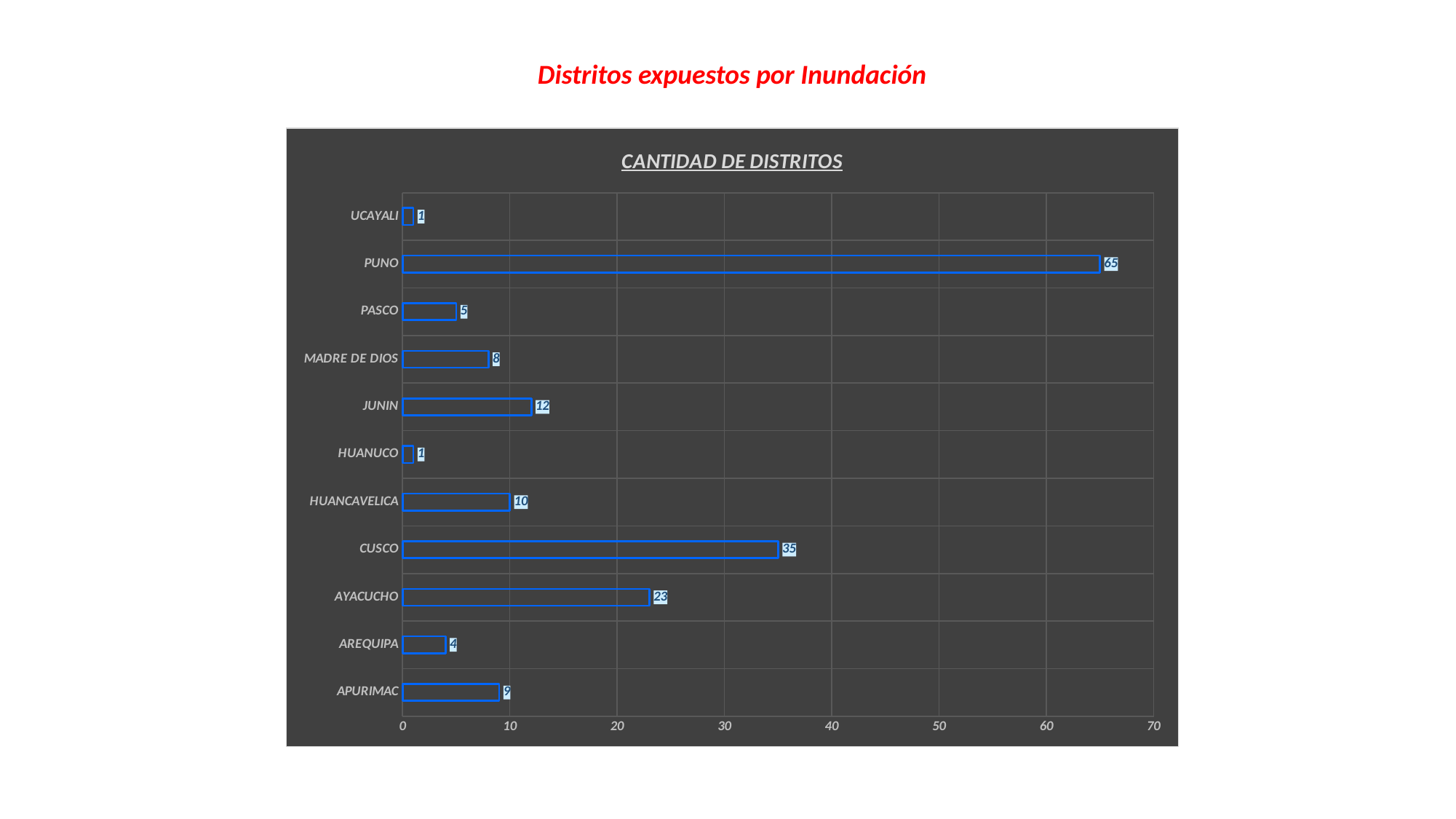
Which is larger, the value for APURIMAC or the value for PASCO? APURIMAC What is the value for PUNO? 65 What is the title of the chart? CANTIDAD DE DISTRITOS What is the difference between the values for JUNIN and MADRE DE DIOS? 4 What is the value for HUANCAVELICA? 10 Which is larger, the value for AYACUCHO or the value for JUNIN? AYACUCHO What is the difference between the values for PUNO and CUSCO? 30 What kind of chart is shown on the slide? Bar chart What is the value for CUSCO? 35 How many categories are shown on the chart? 11 What is the value for AYACUCHO? 23 Which category has the highest value? PUNO